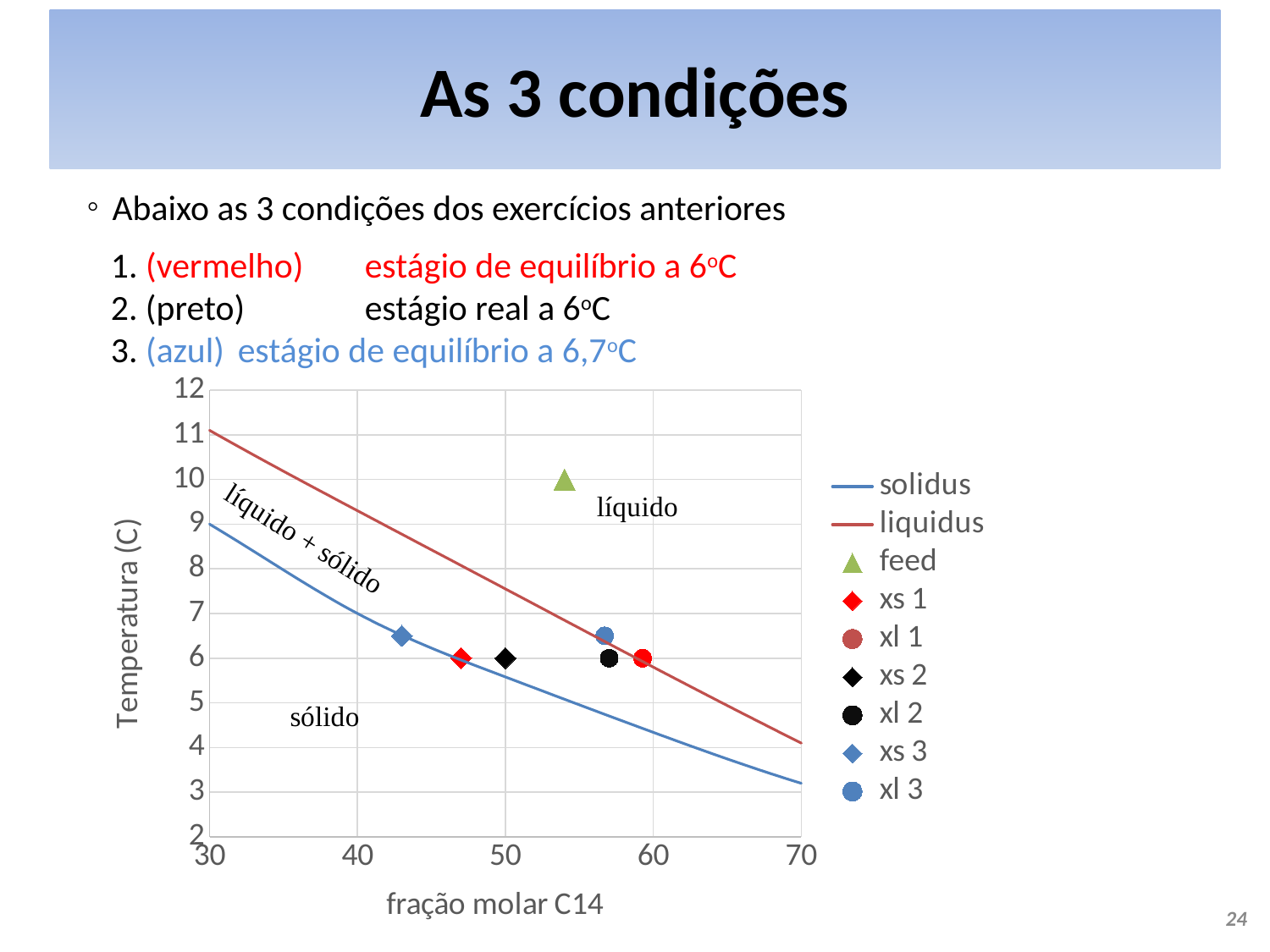
What is the temperature of the xs 2 point? 6 Which plotted point has the lowest fração molar C14? xs 3 What is the fração molar C14 of the xs 2 point? 50 How many series does the chart legend list? 9 Is the fração molar C14 of the xl 1 point greater or less than 50? greater What kind of chart is shown on the slide? scatter chart with lines Does the solidus line rise or fall as fração molar C14 increases? fall What is the title of the y axis of the chart? Temperatura (C) What is the temperature of the feed point? 10 Is the fração molar C14 of the xs 3 point greater or less than 50? less Which plotted point has the highest temperature? feed What is the title of the x axis of the chart? fração molar C14